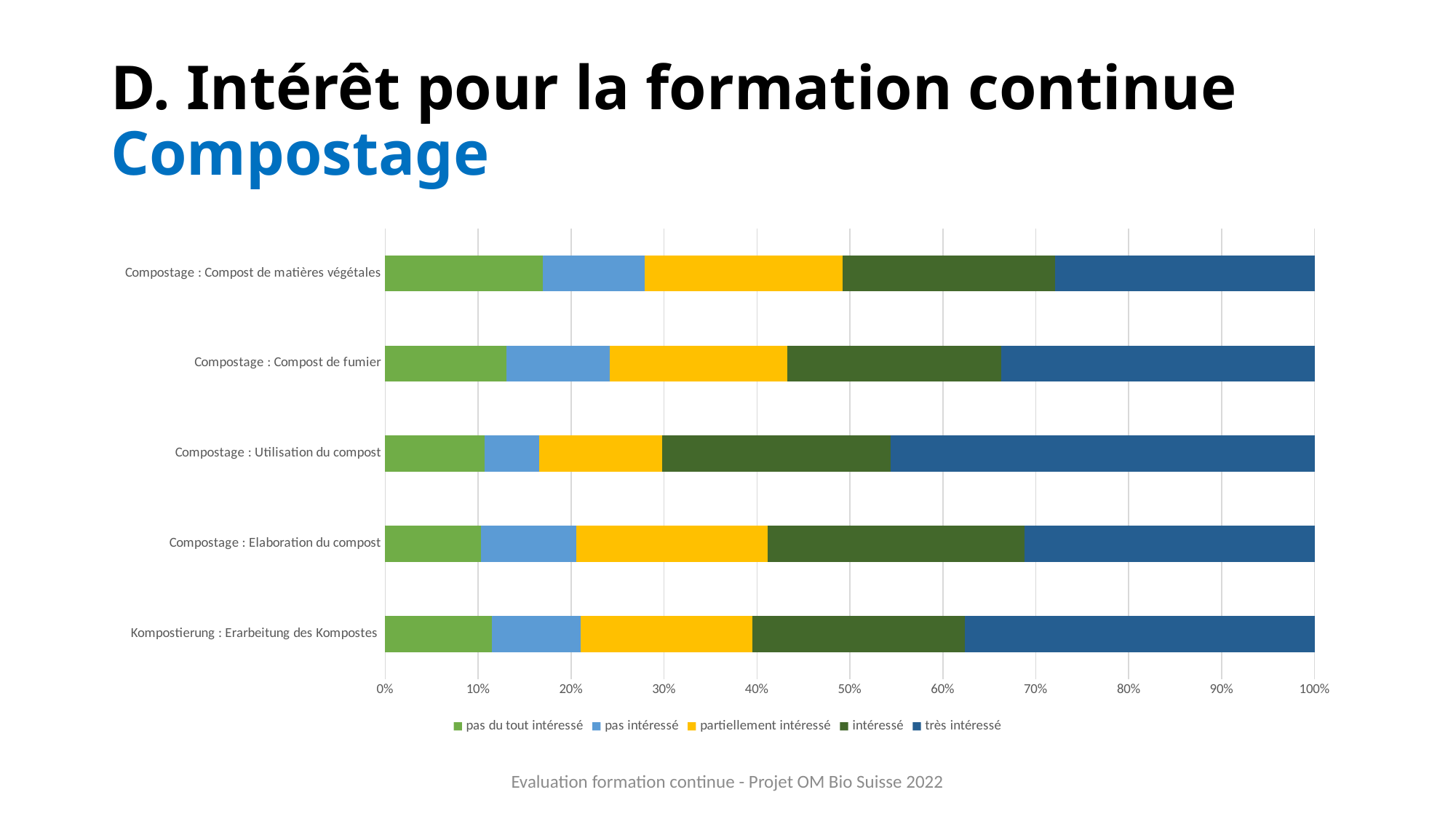
Is the 'très intéressé' share for 'Compostage : Utilisation du compost' greater or less than 40%? greater Is the 'pas du tout intéressé' share for 'Compostage : Compost de matières végétales' greater or less than 10%? greater What is the last entry in the chart legend? très intéressé Which has the larger 'partiellement intéressé' share: 'Compostage : Compost de matières végétales' or 'Compostage : Utilisation du compost'? Compostage : Compost de matières végétales What is the first entry in the chart legend? pas du tout intéressé What kind of chart is shown on the slide? stacked bar chart Which category has the largest 'pas du tout intéressé' share? Compostage : Compost de matières végétales Is the 'pas intéressé' share for 'Compostage : Utilisation du compost' greater or less than 10%? less Which category has the largest 'très intéressé' share? Compostage : Utilisation du compost What value does each stacked bar reach on the x axis? 100% How many categories (bars) does the chart show? 5 How many series does the legend list? 5